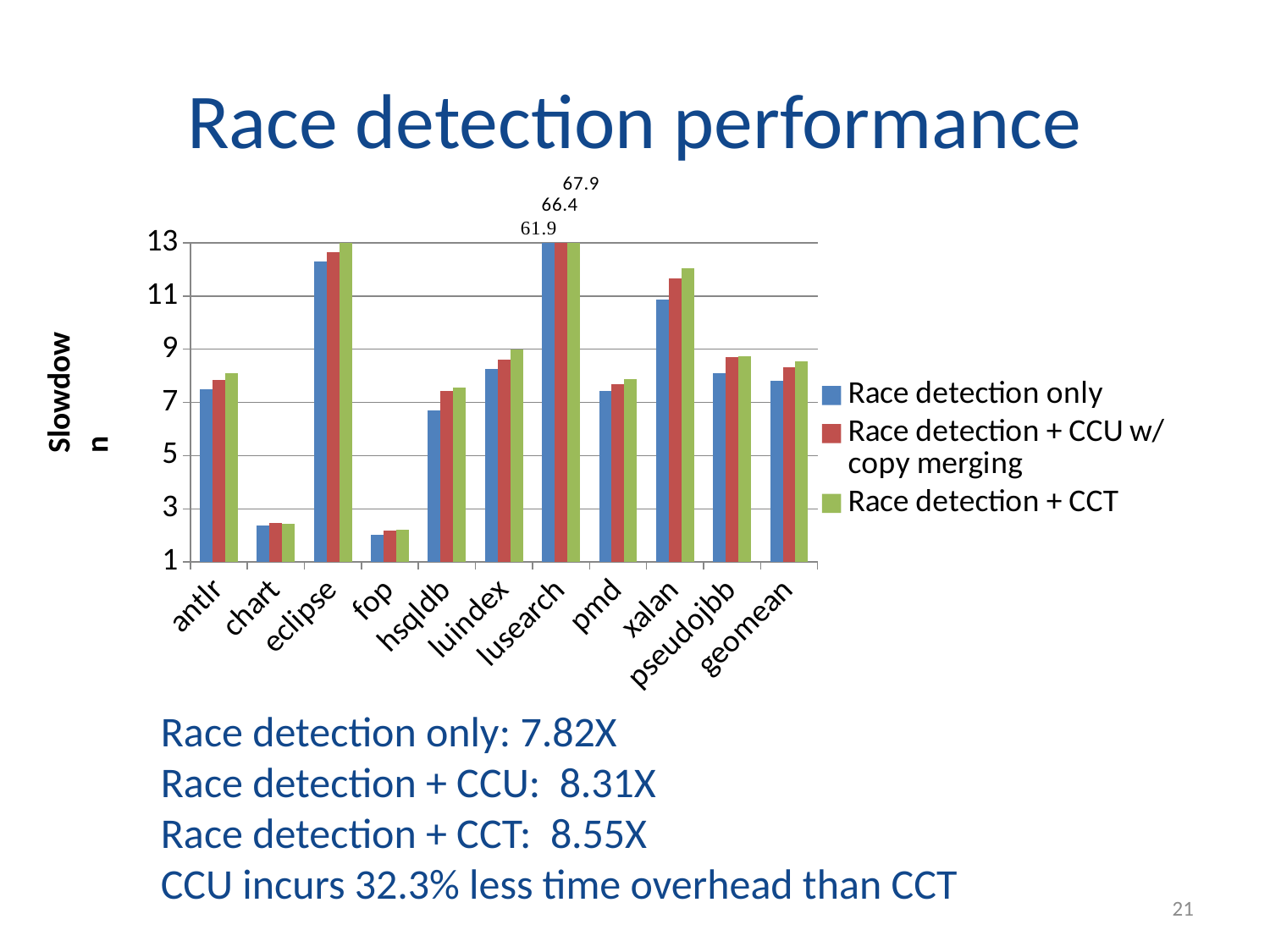
Is the Race detection only value for chart greater or less than 3? less What are the three data labels printed above the lusearch bars? 61.9, 66.4, 67.9 What is the label on the y axis? Slowdown Which category has the lowest slowdown values? fop How many benchmark categories are shown on the x axis? 11 What kind of chart is shown on the slide? bar chart Is the Race detection + CCT value for pmd greater or less than 9? less For Race detection only, which is larger: eclipse or xalan? eclipse Is the Race detection + CCT value for eclipse greater or less than 11? greater Which category has the highest slowdown values? lusearch What is the difference between the highest and lowest data labels printed for lusearch? 6.0 How many series does the legend list? 3